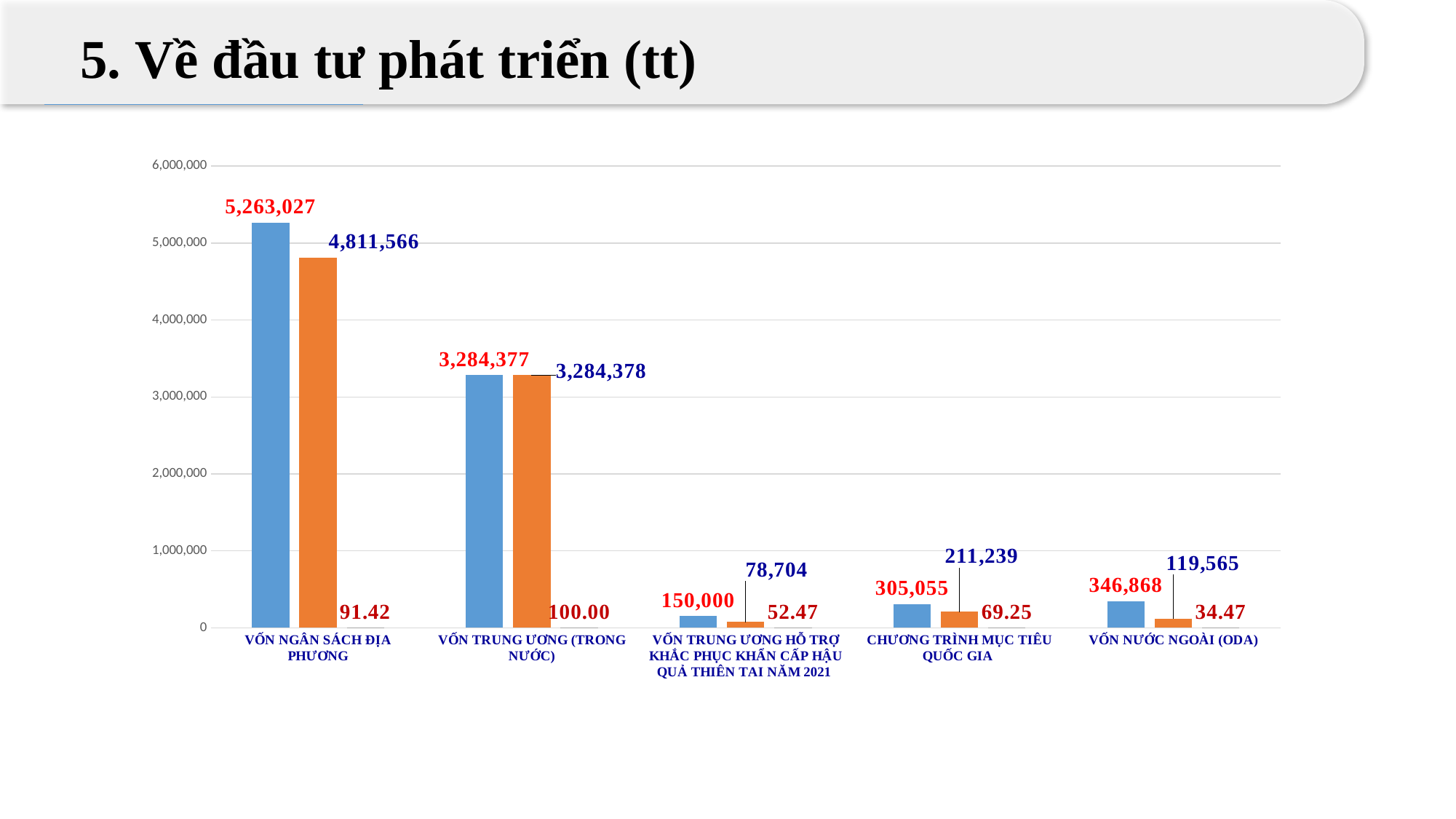
What is the difference between the blue bar and the orange bar for VỐN NGÂN SÁCH ĐỊA PHƯƠNG? 451,461 What is the red percentage label shown for CHƯƠNG TRÌNH MỤC TIÊU QUỐC GIA? 69.25 What is the value of the orange bar for VỐN NƯỚC NGOÀI (ODA)? 119,565 Is the blue bar for VỐN TRUNG ƯƠNG (TRONG NƯỚC) greater or less than 3,000,000? greater What is the value of the blue bar for VỐN NGÂN SÁCH ĐỊA PHƯƠNG? 5,263,027 What is the difference between the blue bar and the orange bar for VỐN NƯỚC NGOÀI (ODA)? 227,303 Which category has the highest blue bar? VỐN NGÂN SÁCH ĐỊA PHƯƠNG What kind of chart is shown on the slide? bar chart Which category has the lowest orange bar? VỐN TRUNG ƯƠNG HỖ TRỢ KHẮC PHỤC KHẨN CẤP HẬU QUẢ THIÊN TAI NĂM 2021 Which has the larger blue bar: CHƯƠNG TRÌNH MỤC TIÊU QUỐC GIA or VỐN NƯỚC NGOÀI (ODA)? VỐN NƯỚC NGOÀI (ODA) Which category has the lowest red percentage label? VỐN NƯỚC NGOÀI (ODA) How many categories are shown along the x axis of the chart? 5